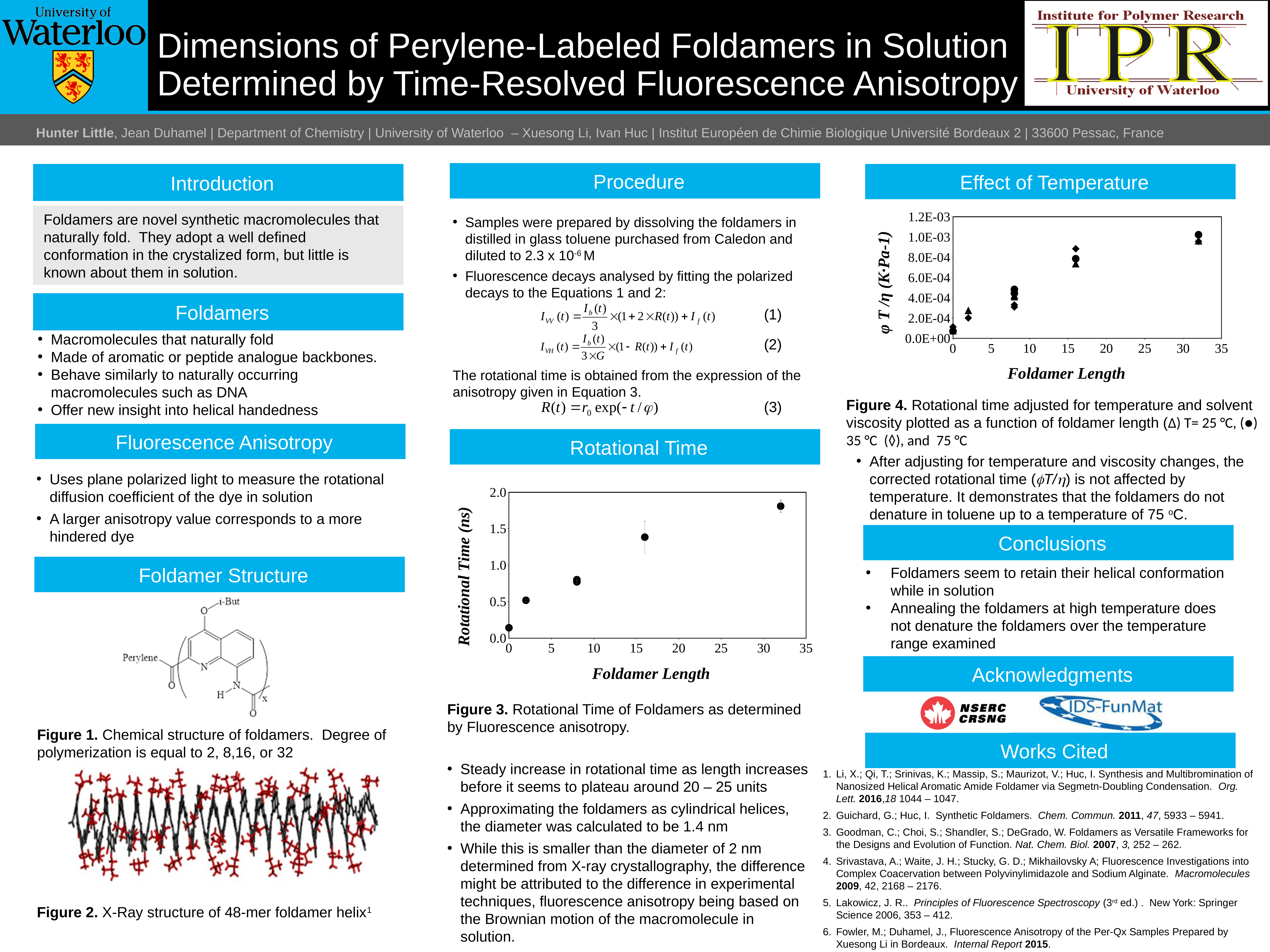
In the Effect of Temperature chart, do the values rise or fall as foldamer length increases? rise In the Rotational Time chart, which foldamer length has the highest rotational time? 32 In the Rotational Time chart, is the rotational time at foldamer length 32 greater or less than 1.5? greater What kind of chart is the Rotational Time chart? scatter chart In the Rotational Time chart, is the rotational time at foldamer length 2 greater or less than 1.0? less In the Rotational Time chart, is the rotational time at foldamer length 16 greater or less than 1.0? greater In the Rotational Time chart, how many data points are plotted? 6 What is the y-axis label of the Rotational Time chart? Rotational Time (ns) In the Rotational Time chart, which foldamer length has the lowest rotational time? 0 In the Rotational Time chart, do rotational time values rise or fall as foldamer length increases? rise